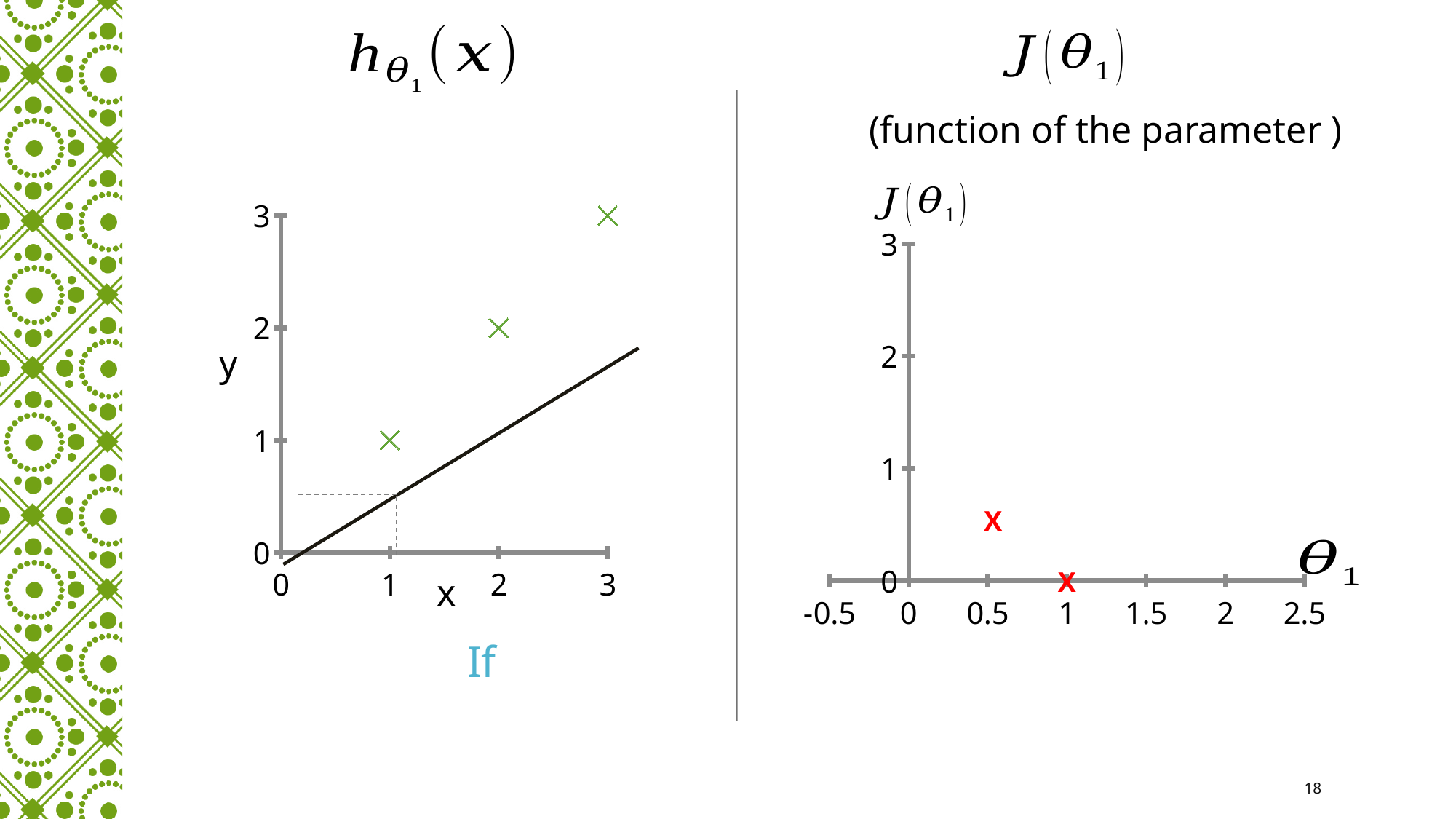
On the left chart titled h_θ1(x), what is the y value of the data point at x = 2? 2 On the right chart titled J(θ1), how many red x marks are plotted? 2 On the left chart titled h_θ1(x), what is the y value of the data point at x = 3? 3 On the right chart titled J(θ1), which of the two plotted points has the larger J(θ1) value, the one at θ1 = 0.5 or the one at θ1 = 1? θ1 = 0.5 On the left chart titled h_θ1(x), what is the label of the vertical axis? y On the left chart titled h_θ1(x), do the y values of the data points rise or fall as x increases? rise On the left chart titled h_θ1(x), how many green X data points are plotted? 3 On the left chart titled h_θ1(x), which data point has the highest y value? x = 3 On the left chart titled h_θ1(x), is the value of the black line at x = 1 greater or less than 1? less On the right chart titled J(θ1), what is the lowest value shown on the horizontal axis? -0.5 On the right chart titled J(θ1), is the value of J(θ1) at θ1 = 0.5 greater or less than 1? less On the right chart titled J(θ1), what is the value of J(θ1) at θ1 = 1? 0